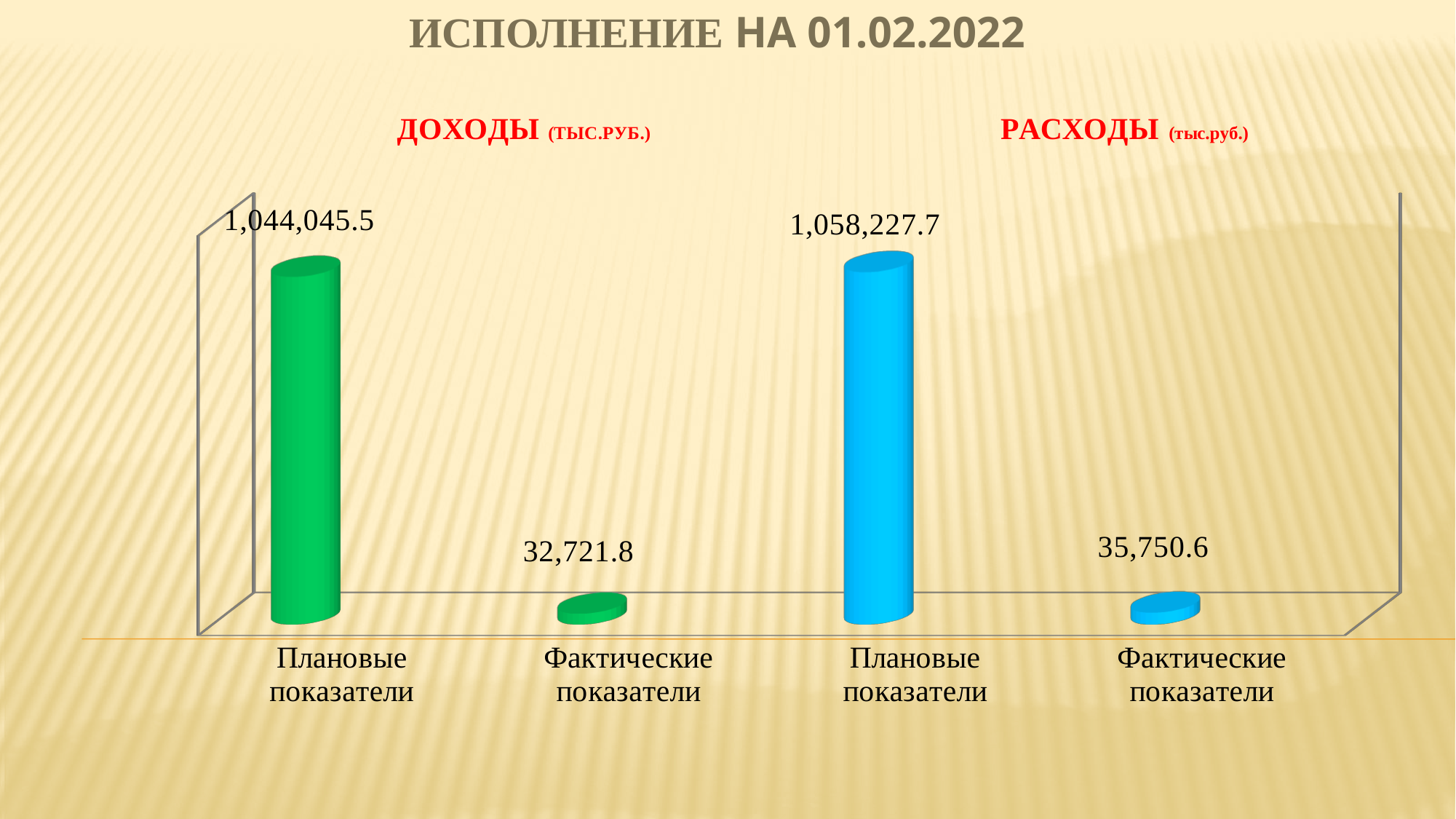
What is the value of the Плановые показатели bar in the РАСХОДЫ group? 1,058,227.7 How many bars are plotted on the chart? 4 What kind of chart is shown on the slide? Bar chart What is the value of the Фактические показатели bar in the ДОХОДЫ group? 32,721.8 Which bar on the chart has the lowest value? Фактические показатели (ДОХОДЫ), 32,721.8 What is the value of the Фактические показатели bar in the РАСХОДЫ group? 35,750.6 Which is larger: the Фактические показатели value for ДОХОДЫ or for РАСХОДЫ? РАСХОДЫ (35,750.6) What is the value of the Плановые показатели bar in the ДОХОДЫ group? 1,044,045.5 What is the difference between the Плановые показатели and Фактические показатели values in the ДОХОДЫ group? 1,011,323.7 What is the title of the slide? ИСПОЛНЕНИЕ НА 01.02.2022 Which bar on the chart has the highest value? Плановые показатели (РАСХОДЫ), 1,058,227.7 What is the difference between the Плановые показатели values of РАСХОДЫ and ДОХОДЫ? 14,182.2